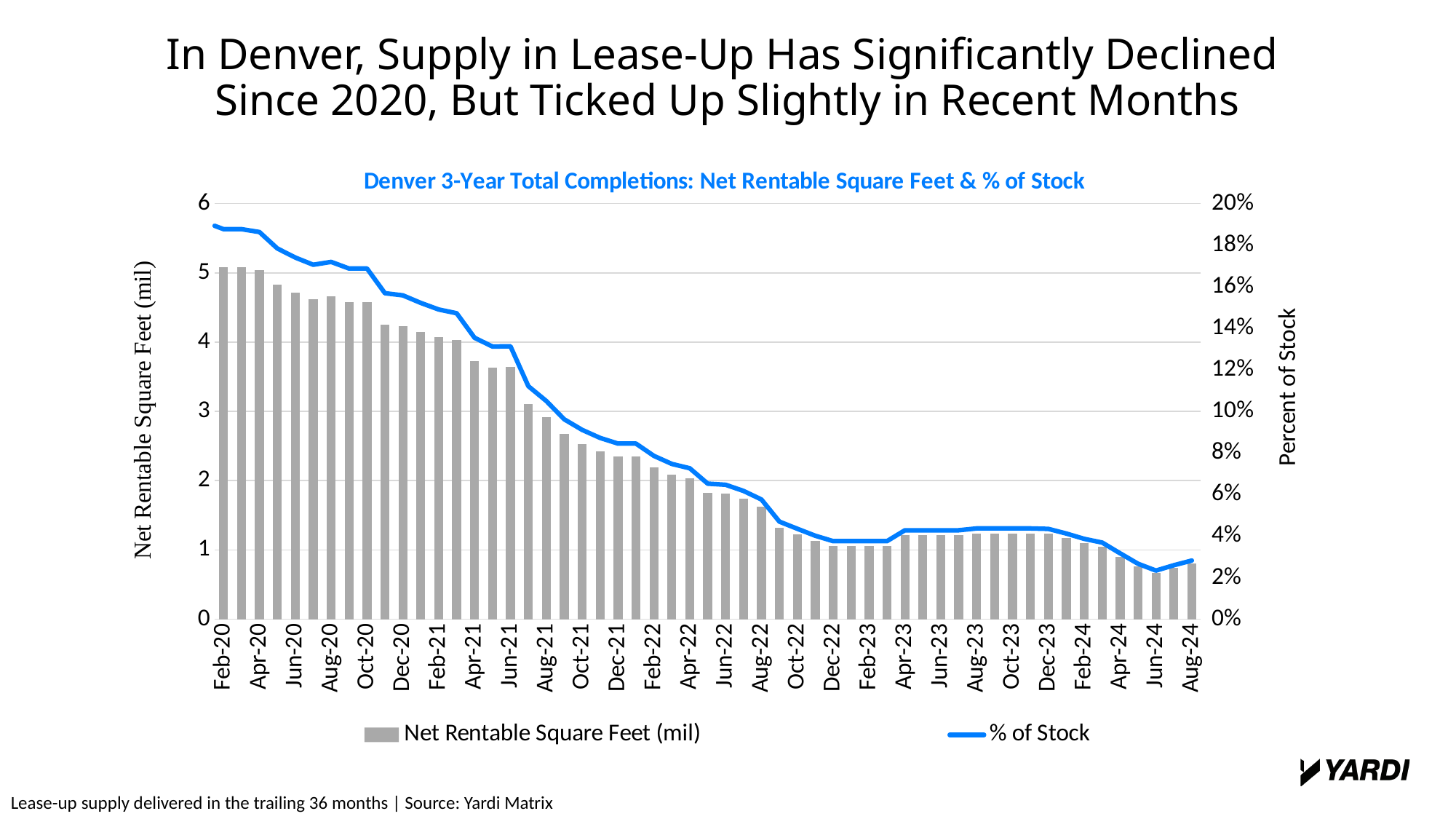
Is the % of Stock value for Feb-20 greater or less than 16%? greater Is the Net Rentable Square Feet (mil) value for Aug-24 greater or less than 1? less Which series is plotted as a blue line? % of Stock What is the title of the chart? Denver 3-Year Total Completions: Net Rentable Square Feet & % of Stock Is the Net Rentable Square Feet (mil) value for Dec-22 greater or less than 2? less Overall, does the % of Stock line rise or fall from Feb-20 to Aug-24? fall What kind of chart is shown on the slide? A combination bar and line chart Which is larger, the Net Rentable Square Feet (mil) value for Feb-20 or for Aug-24? Feb-20 How many series does the legend list? 2